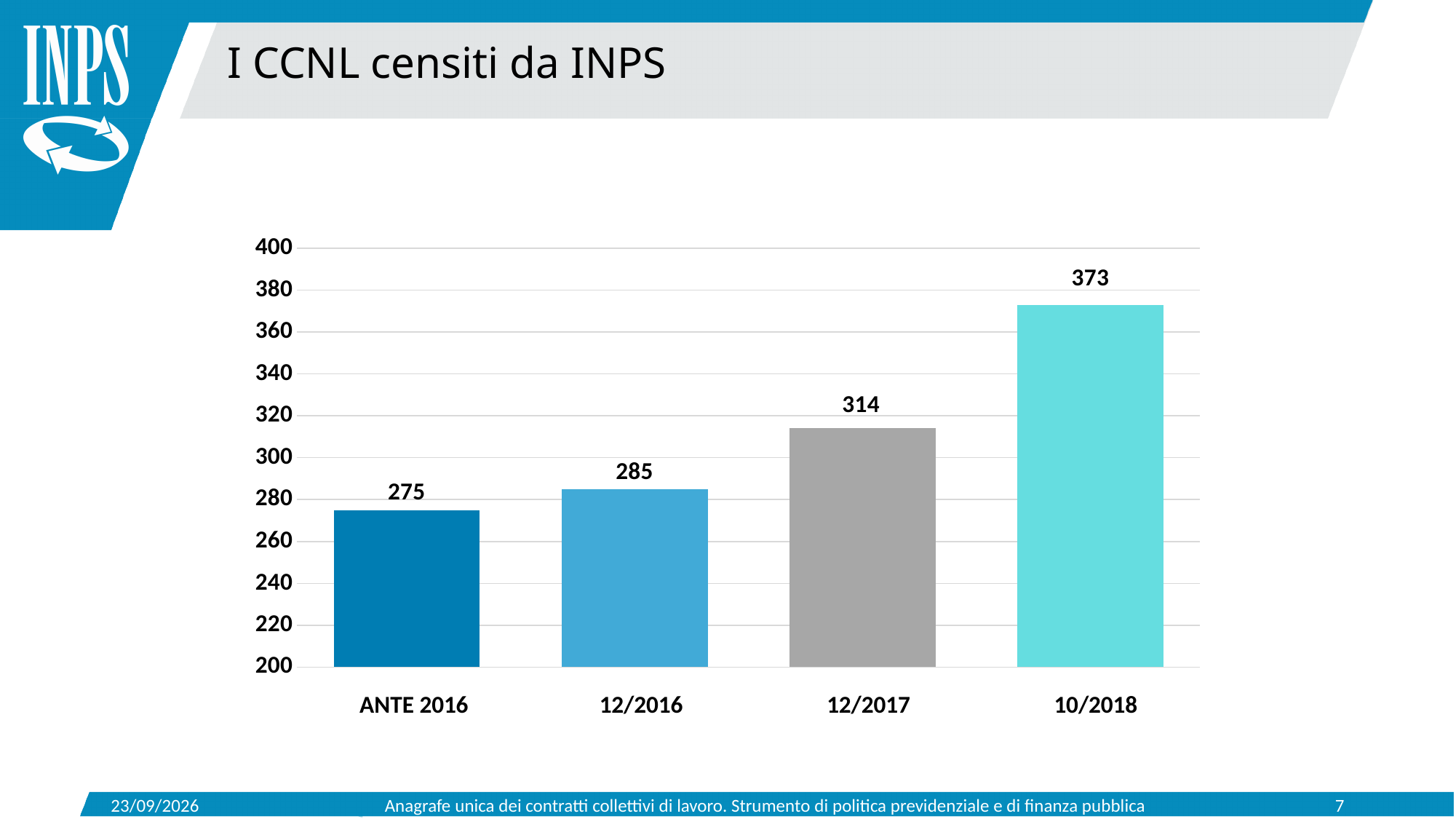
What kind of chart is shown on the slide? bar chart How many categories are shown on the x axis? 4 What is the value for ANTE 2016? 275 What is the value for 12/2016? 285 Which category has the highest value? 10/2018 Which category has the lowest value? ANTE 2016 What is the value for 10/2018? 373 Do the values rise or fall from ANTE 2016 to 10/2018? rise What is the value for 12/2017? 314 What is the difference between the values for 12/2016 and ANTE 2016? 10 What is the difference between the values for 10/2018 and 12/2017? 59 Which is larger, the value for 12/2017 or the value for 12/2016? 12/2017